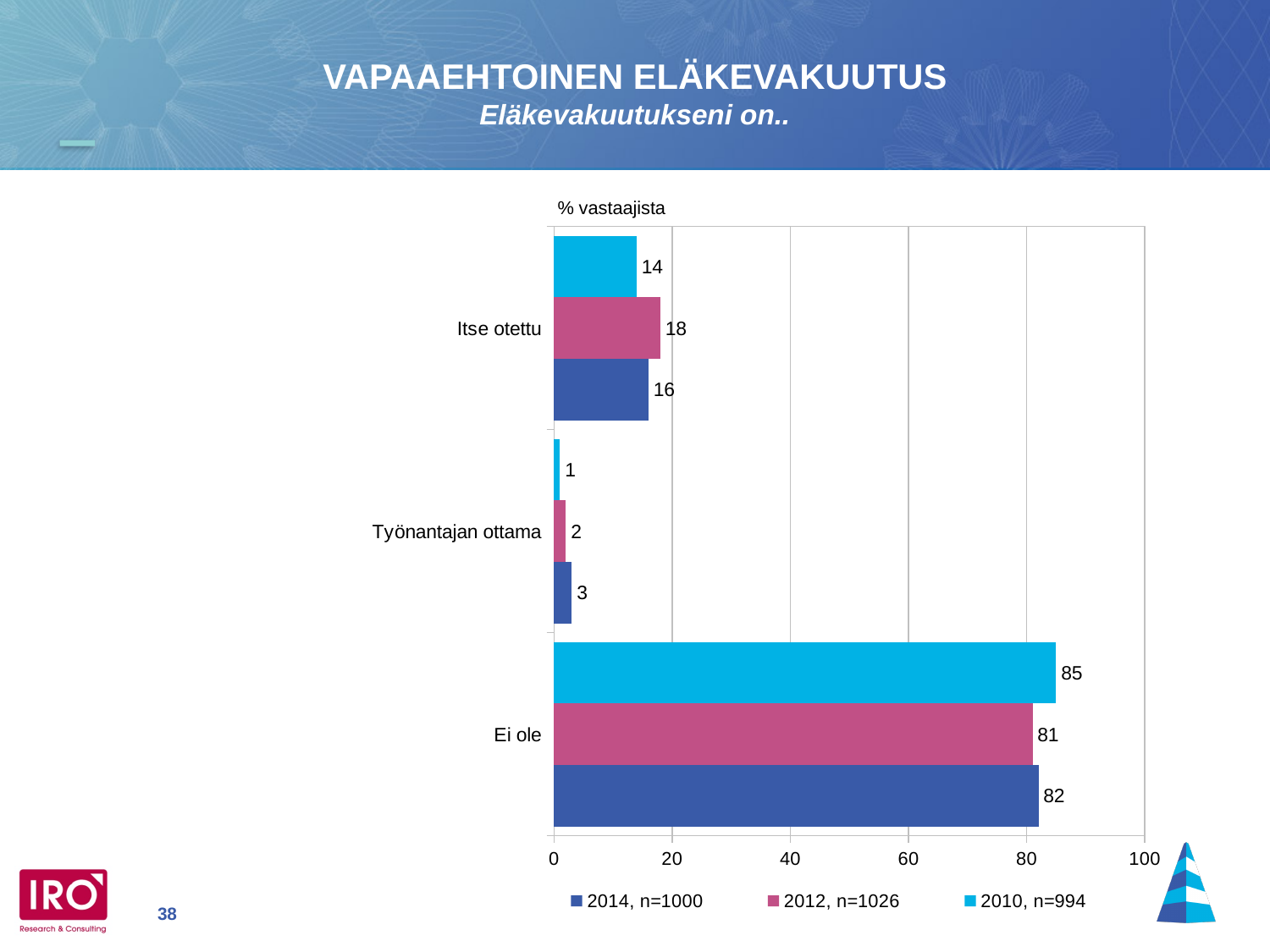
What is the label shown above the chart's plot area? % vastaajista What is the value for "Ei ole" in the 2010, n=994 series? 85 Which category has the lowest value in the 2010, n=994 series? Työnantajan ottama How many categories are shown on the chart? 3 What is the value for "Itse otettu" in the 2012, n=1026 series? 18 What kind of chart is shown on the slide? Bar chart What is the difference between the 2010, n=994 and 2012, n=1026 values for "Ei ole"? 4 For "Itse otettu", which series has the larger value: 2012, n=1026 or 2014, n=1000? 2012, n=1026 Is the value for "Ei ole" in the 2014, n=1000 series greater or less than 80? greater Which category has the highest value in the 2014, n=1000 series? Ei ole How many series does the legend list? 3 What is the value for "Työnantajan ottama" in the 2014, n=1000 series? 3